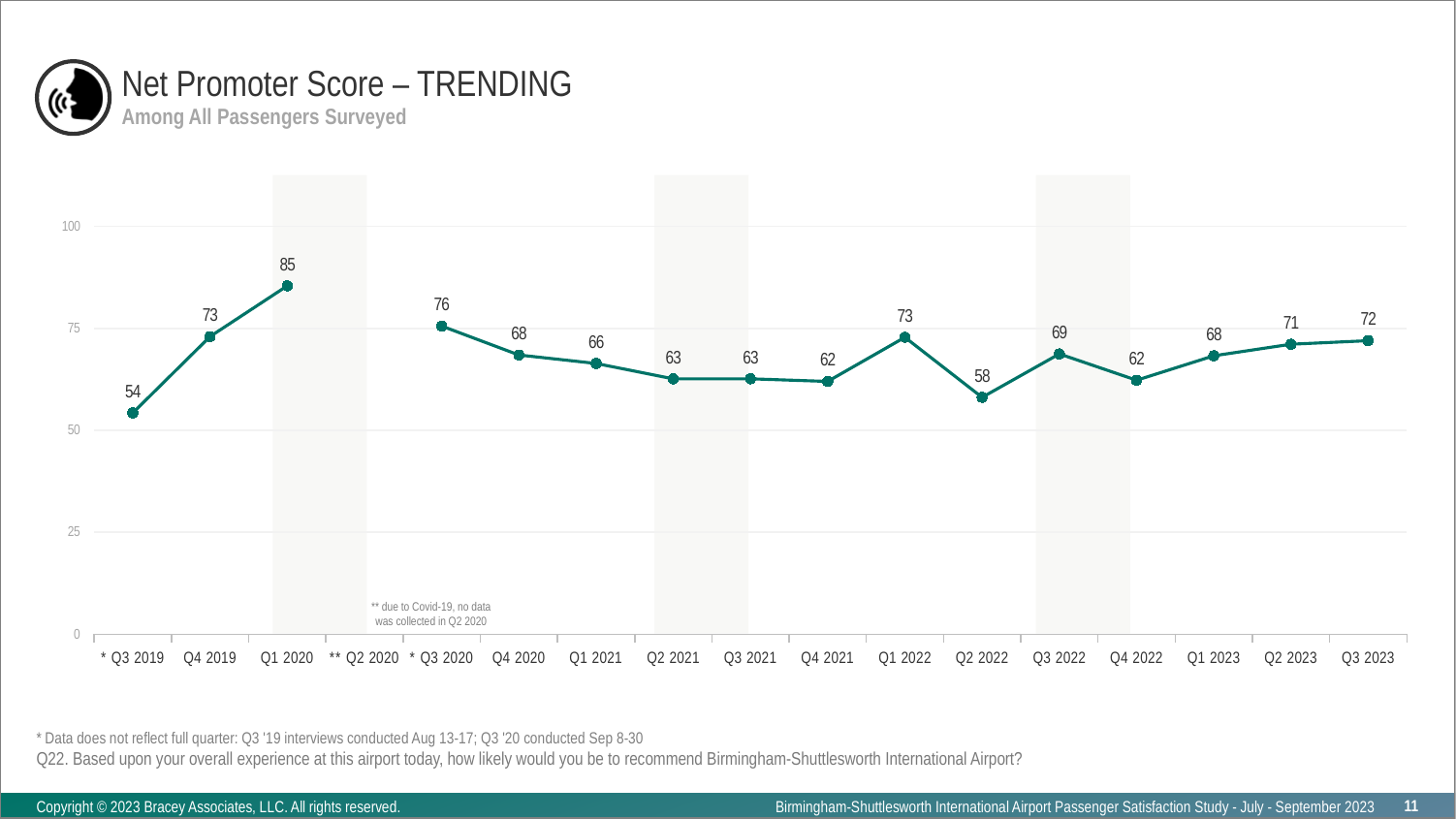
How many quarters are labelled on the x axis of the chart? 17 What kind of chart is shown on the slide? line chart What is the difference between the Net Promoter Score in Q1 2020 and in Q3 2019? 31 What is the difference between the Net Promoter Score in Q1 2022 and in Q2 2022? 15 Does the Net Promoter Score rise or fall from Q3 2019 to Q1 2020? rise What is the Net Promoter Score for Q3 2023? 72 What is the Net Promoter Score for Q3 2020? 76 Which quarter has the highest Net Promoter Score? Q1 2020 Is the Net Promoter Score for Q2 2022 greater or less than 50? greater What is the Net Promoter Score for Q2 2022? 58 Which quarter has the lowest Net Promoter Score? Q3 2019 Which is higher, the Net Promoter Score for Q3 2020 or for Q4 2020? Q3 2020